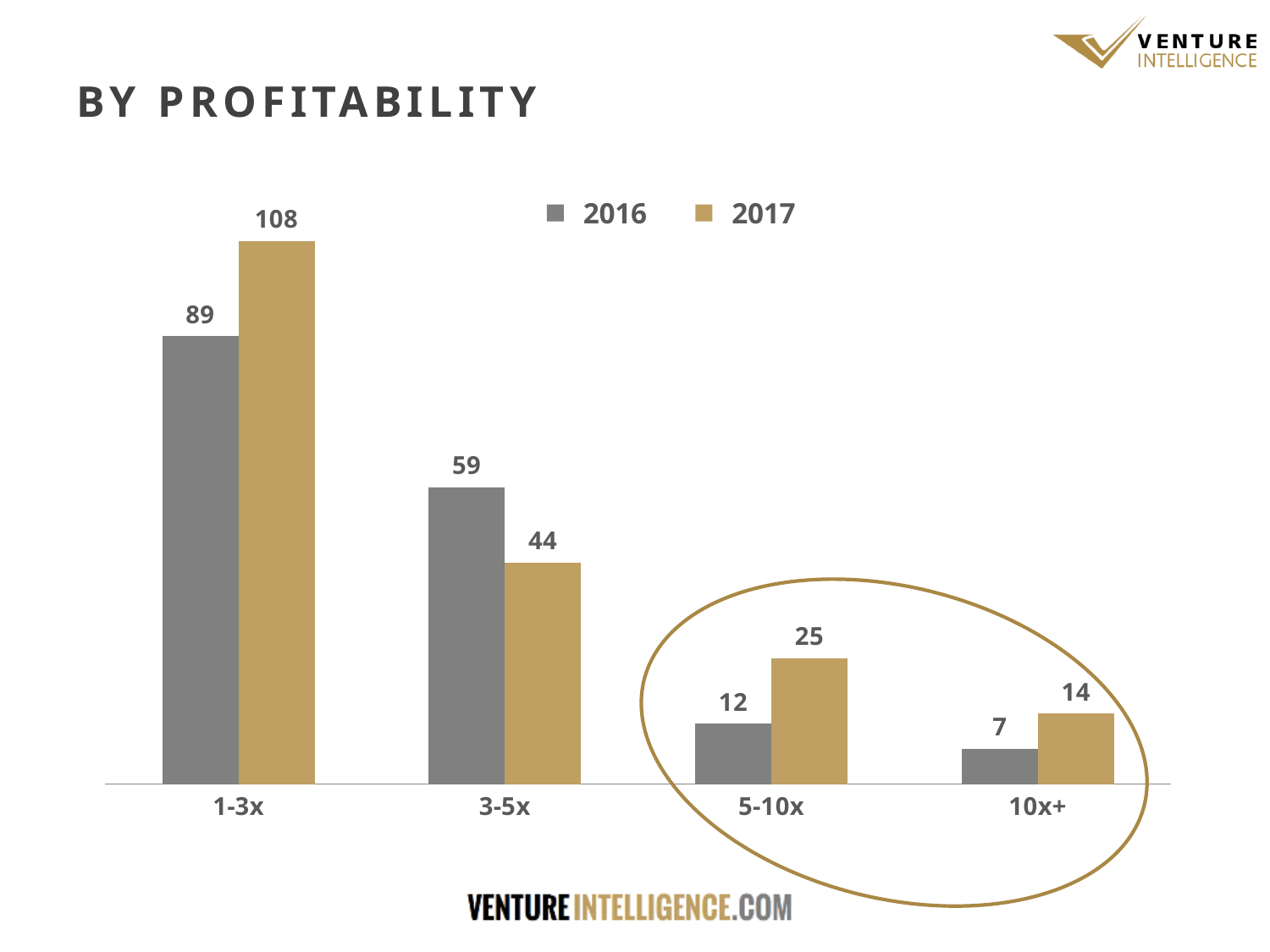
What is the value for 1-3x in 2017? 108 What kind of chart is shown on the slide? bar chart What is the difference between the 2017 and 2016 values for 1-3x? 19 Which categories are circled on the chart? 5-10x and 10x+ Which category has the lowest value in 2017? 10x+ Which category has the highest value in 2016? 1-3x Which is larger for 5-10x, the 2016 value or the 2017 value? 2017 What is the value for 3-5x in 2016? 59 How many series does the legend list? 2 What is the difference between the 2016 and 2017 values for 3-5x? 15 How many categories are shown on the x axis? 4 What is the value for 10x+ in 2016? 7